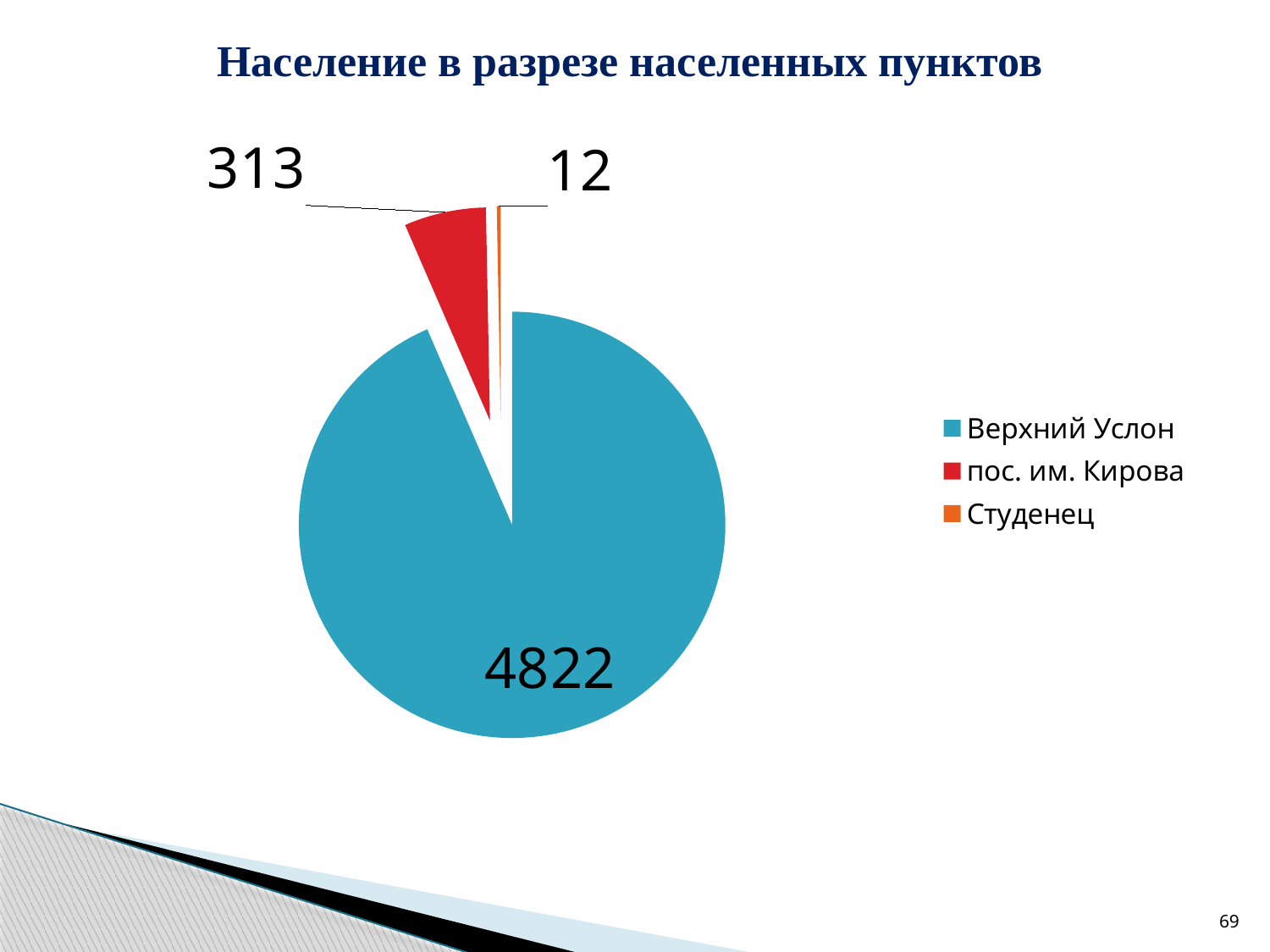
What is the title of the chart? Население в разрезе населенных пунктов What is the difference between the values for пос. им. Кирова and Студенец? 301 What type of chart is shown on the slide? Pie chart What is the value for Верхний Услон? 4822 Which settlement has the largest population in the pie chart? Верхний Услон Which settlement has the smallest population in the pie chart? Студенец Which is larger, the value for пос. им. Кирова or the value for Студенец? пос. им. Кирова How many slices does the pie chart have? 3 What is the total of all values in the pie chart? 5147 What is the difference between the values for Верхний Услон and пос. им. Кирова? 4509 What is the value for пос. им. Кирова? 313 What is the value for Студенец? 12